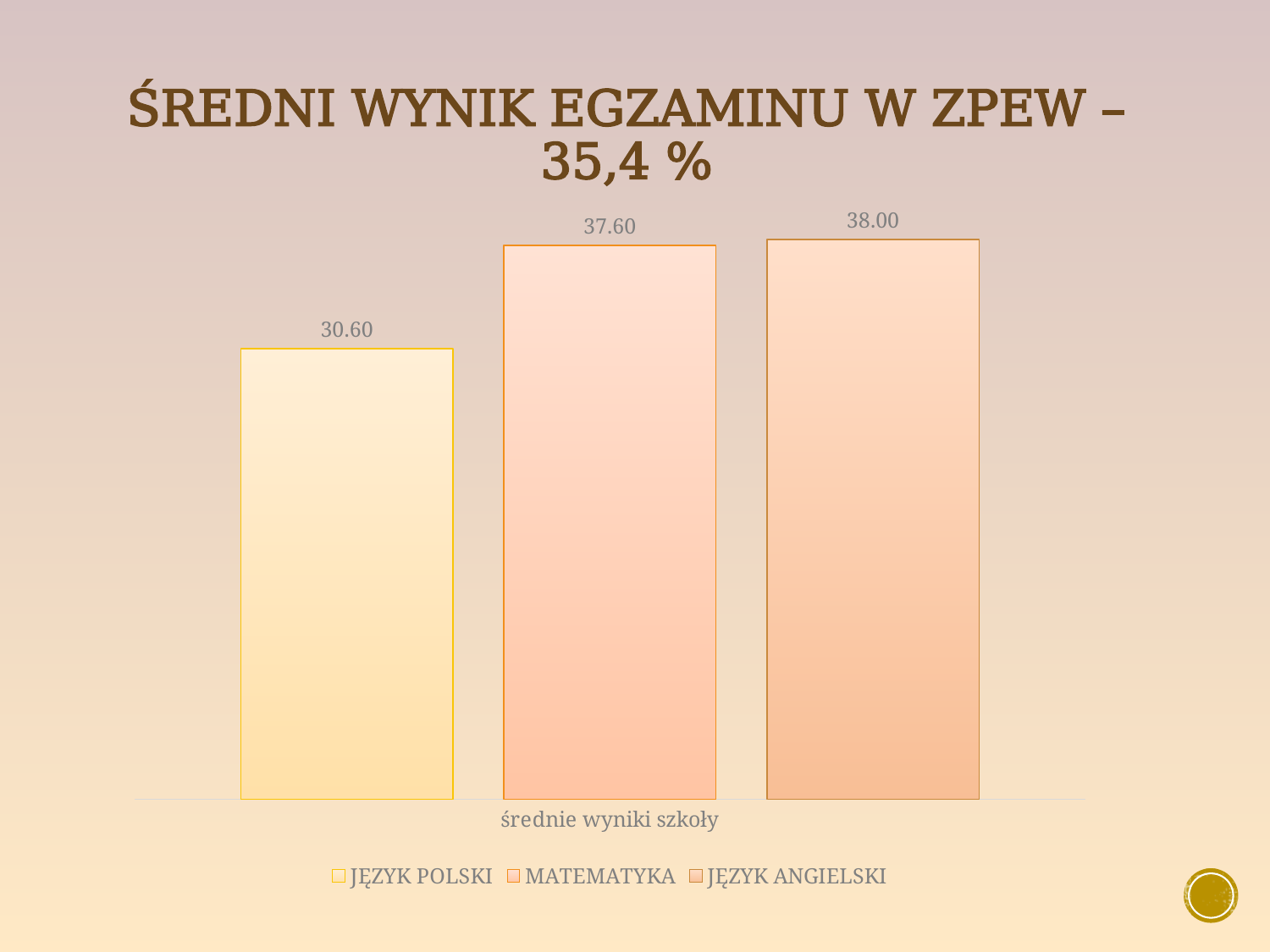
What is the category label shown on the x axis? średnie wyniki szkoły What kind of chart is shown on the slide? Bar chart What is the value for JĘZYK POLSKI? 30.60 What average exam result is stated in the slide title? 35,4 % Which series has the lowest value? JĘZYK POLSKI Which series has the highest value? JĘZYK ANGIELSKI What is the difference between the values for MATEMATYKA and JĘZYK POLSKI? 7.00 What is the value for JĘZYK ANGIELSKI? 38.00 Which is larger, the value for MATEMATYKA or the value for JĘZYK POLSKI? MATEMATYKA What is the difference between the values for JĘZYK ANGIELSKI and JĘZYK POLSKI? 7.40 How many series does the legend list? 3 What is the value for MATEMATYKA? 37.60